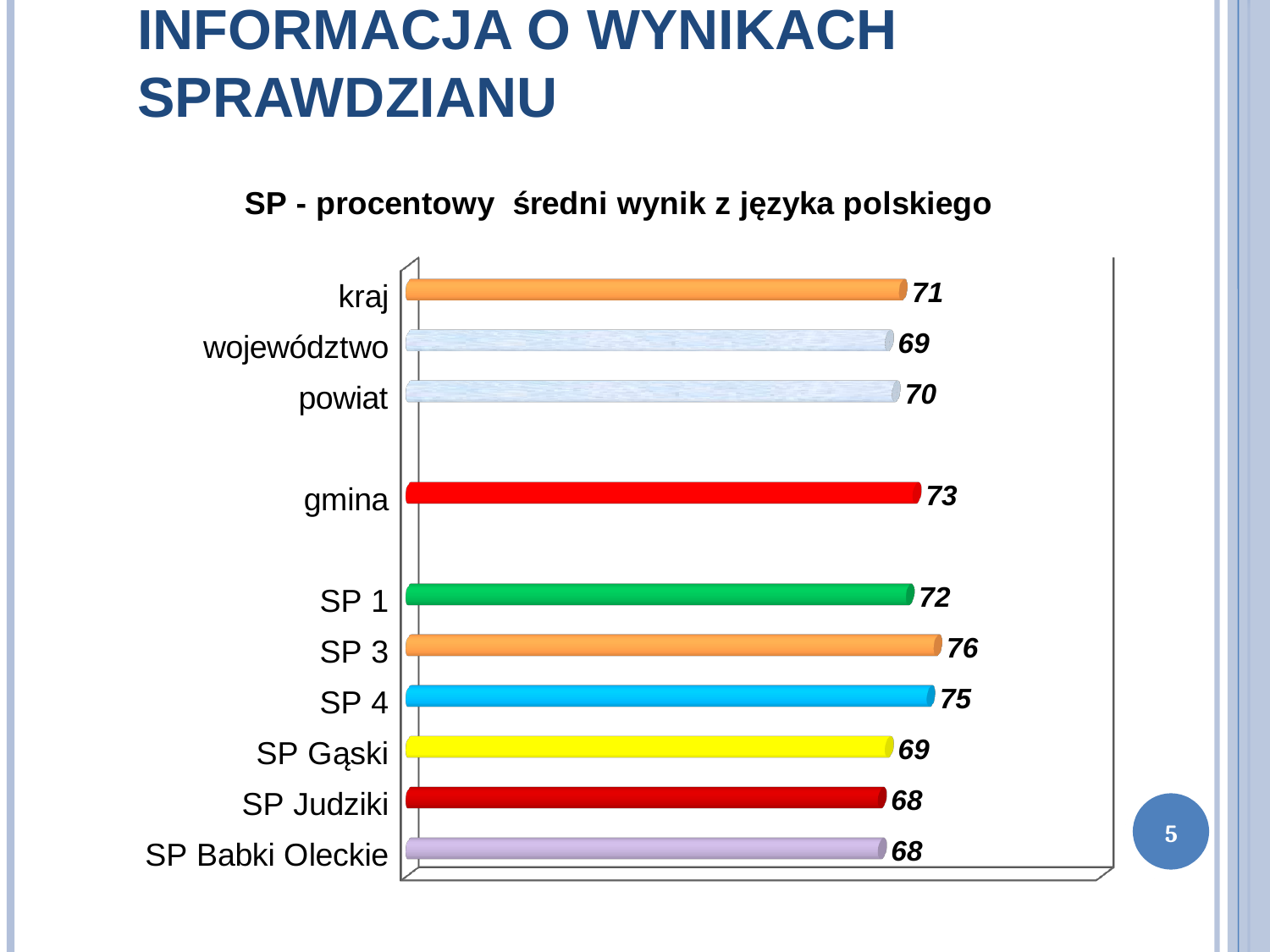
What is the value for SP 3? 76 What is the value for kraj? 71 What is the title of the chart? SP - procentowy średni wynik z języka polskiego What kind of chart is shown on the slide? bar chart Which is larger, the value for województwo or the value for powiat? powiat What is the value for gmina? 73 What is the value for SP Babki Oleckie? 68 What is the difference between the values for gmina and powiat? 3 Which is larger, the value for SP 4 or the value for SP Gąski? SP 4 What is the difference between the values for SP 3 and SP 1? 4 How many categories are shown in the chart? 10 Which category has the highest value? SP 3